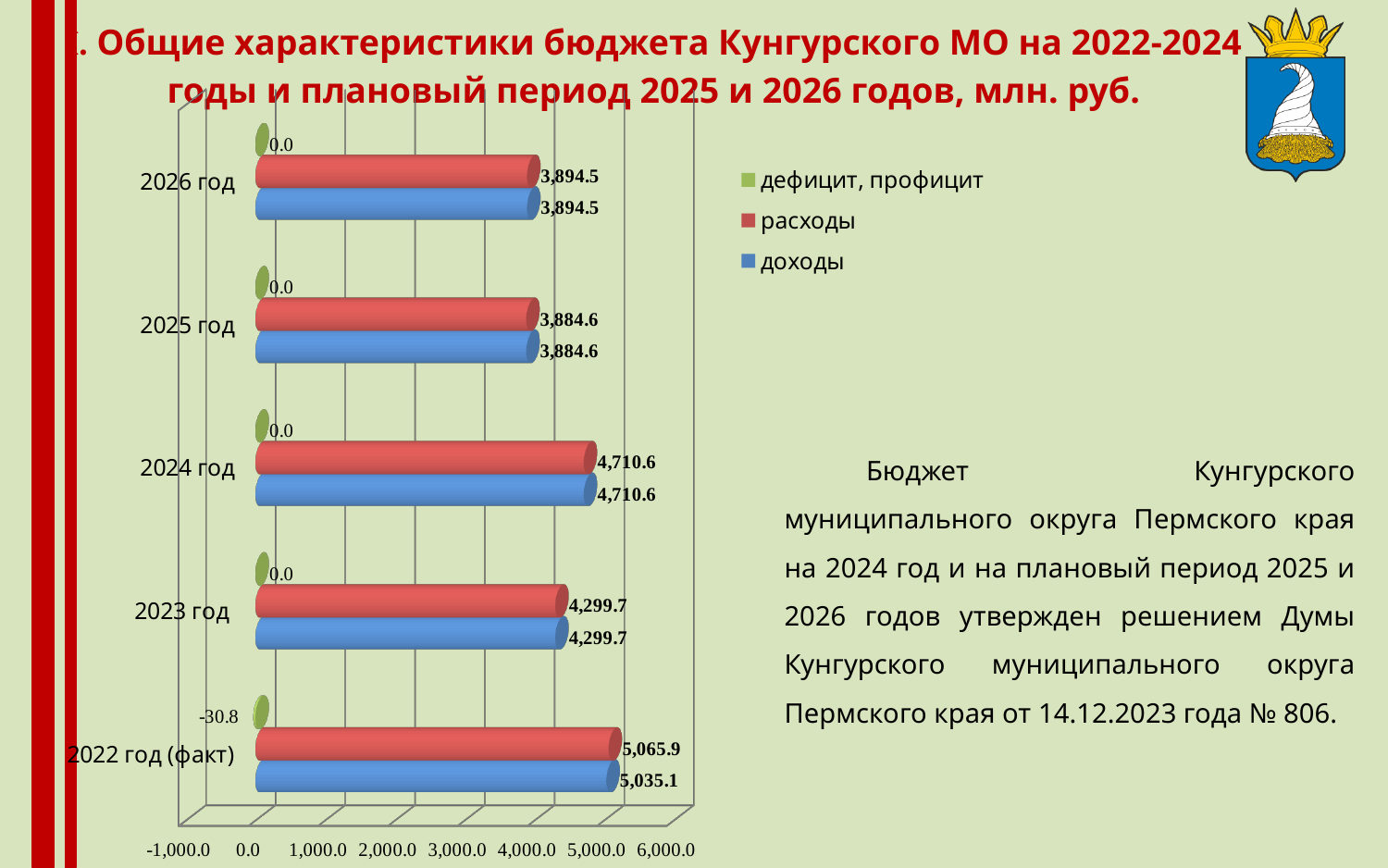
Which year has the lowest value of доходы? 2025 год What is the value of доходы for 2022 год (факт)? 5,035.1 What is the value of дефицит, профицит for 2022 год (факт)? -30.8 What is the value of расходы for 2024 год? 4,710.6 What is the difference between расходы and доходы for 2022 год (факт)? 30.8 Is the value of доходы for 2024 год greater or less than 4,000.0? greater What kind of chart is shown on the slide? bar chart How many series does the legend list? 3 What is the value of доходы for 2026 год? 3,894.5 How many year categories are shown on the chart? 5 Which year has the highest value of расходы? 2022 год (факт) Which is larger, расходы for 2023 год or расходы for 2025 год? расходы for 2023 год